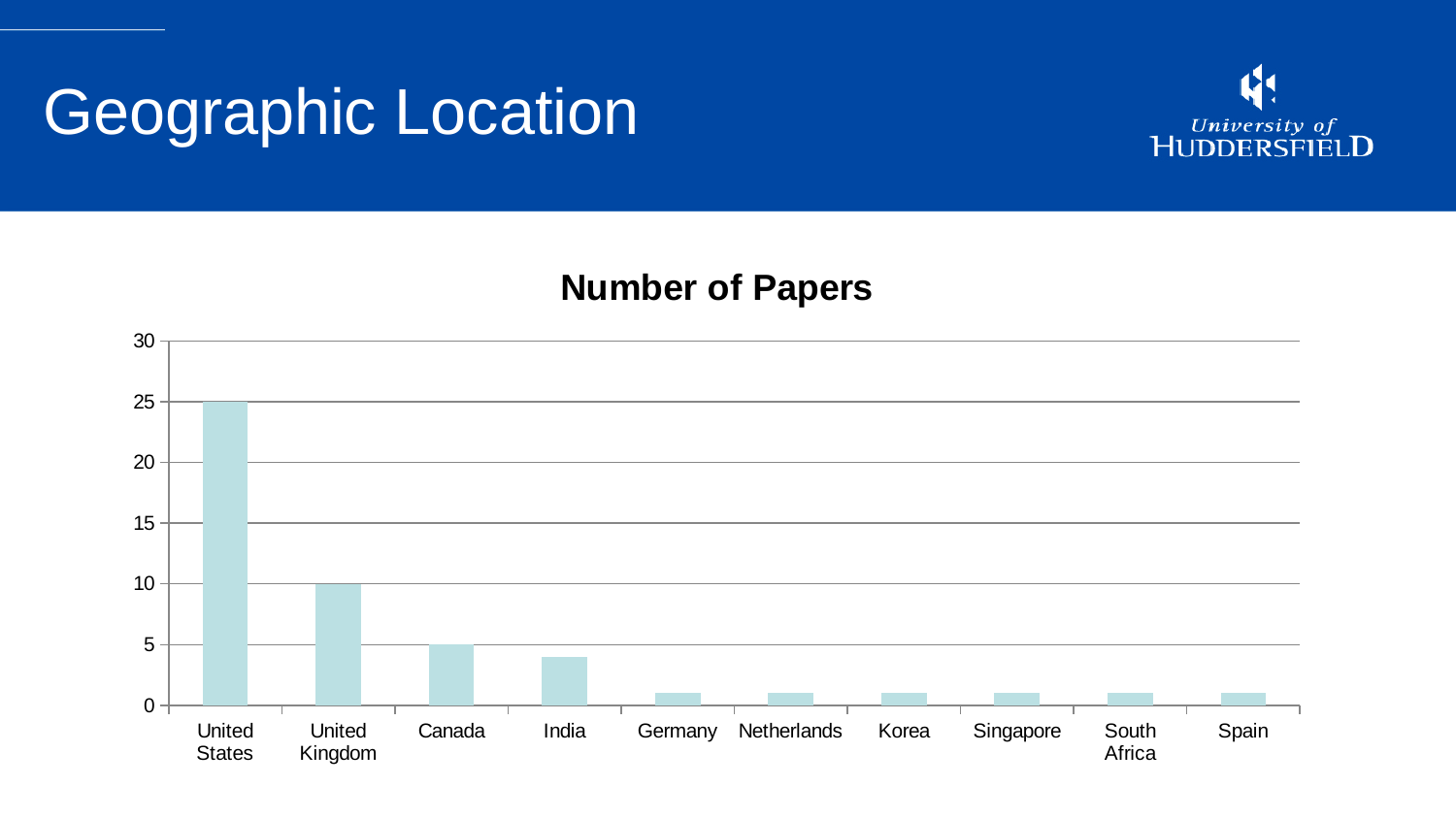
Which has more papers, the United Kingdom or Canada? United Kingdom Is the value for India greater or less than 5? less Which country has the highest number of papers? United States What is the number of papers for the United Kingdom? 10 Is the value for Germany greater or less than 5? less What is the difference in number of papers between the United States and the United Kingdom? 15 What is the number of papers for Canada? 5 Do the values rise or fall moving from left to right along the x axis? Fall How many countries are shown on the x axis of the chart? 10 What type of chart is shown on the slide? Bar chart What is the number of papers for the United States? 25 What is the title of the chart? Number of Papers